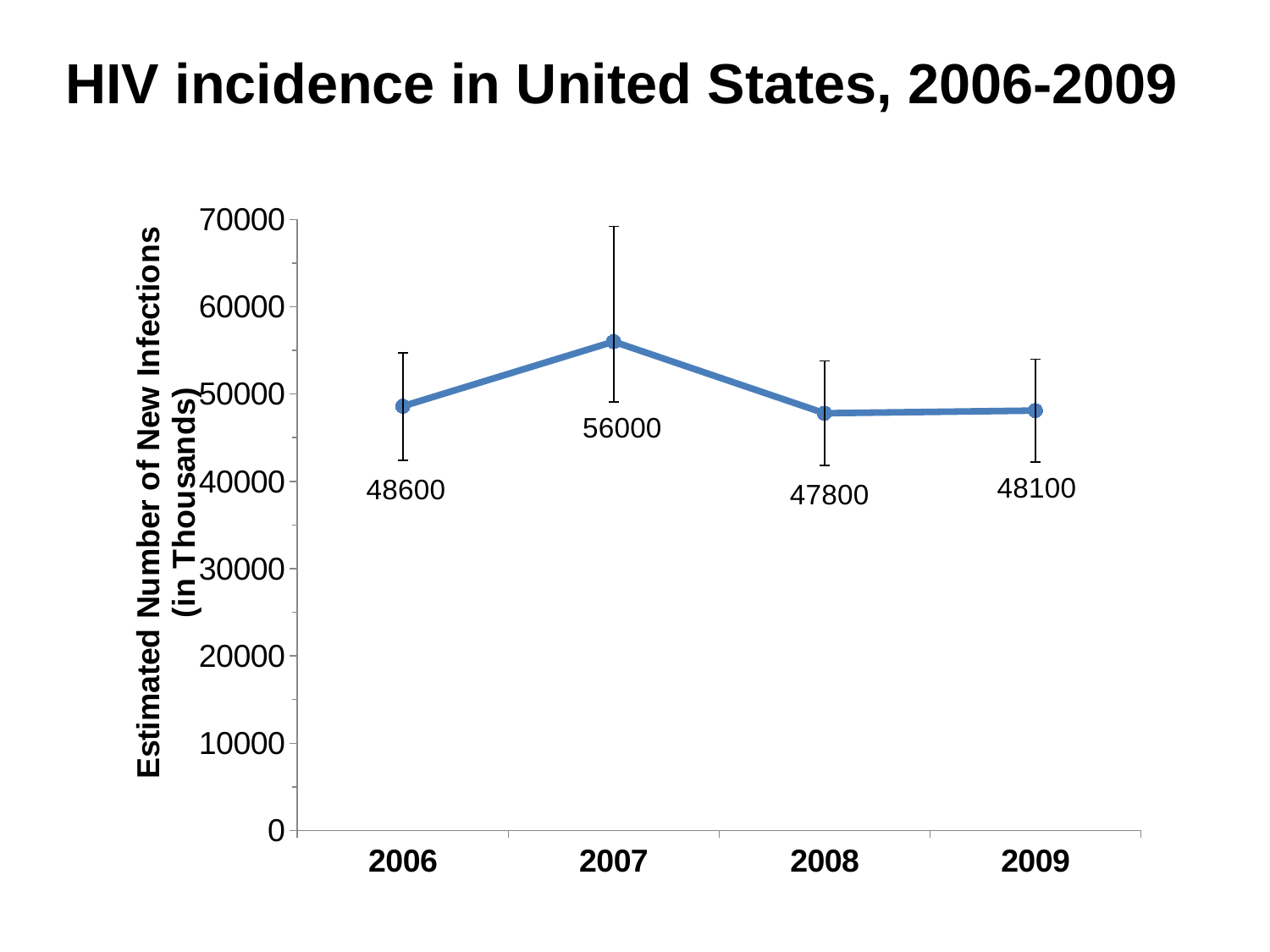
What is the difference between the 2007 and 2008 values? 8200 What is the estimated number of new HIV infections in 2007? 56000 What is the estimated number of new HIV infections in 2006? 48600 How many years are plotted on the chart? 4 Is the value for 2006 or 2007 larger? 2007 What is the difference between the 2006 and 2009 values? 500 What kind of chart is shown on the slide? line chart What is the title of the chart? HIV incidence in United States, 2006-2009 Which year has the highest estimated number of new infections? 2007 What is the estimated number of new HIV infections in 2009? 48100 Which year has the lowest estimated number of new infections? 2008 Is the value for 2007 greater or less than 50000? greater